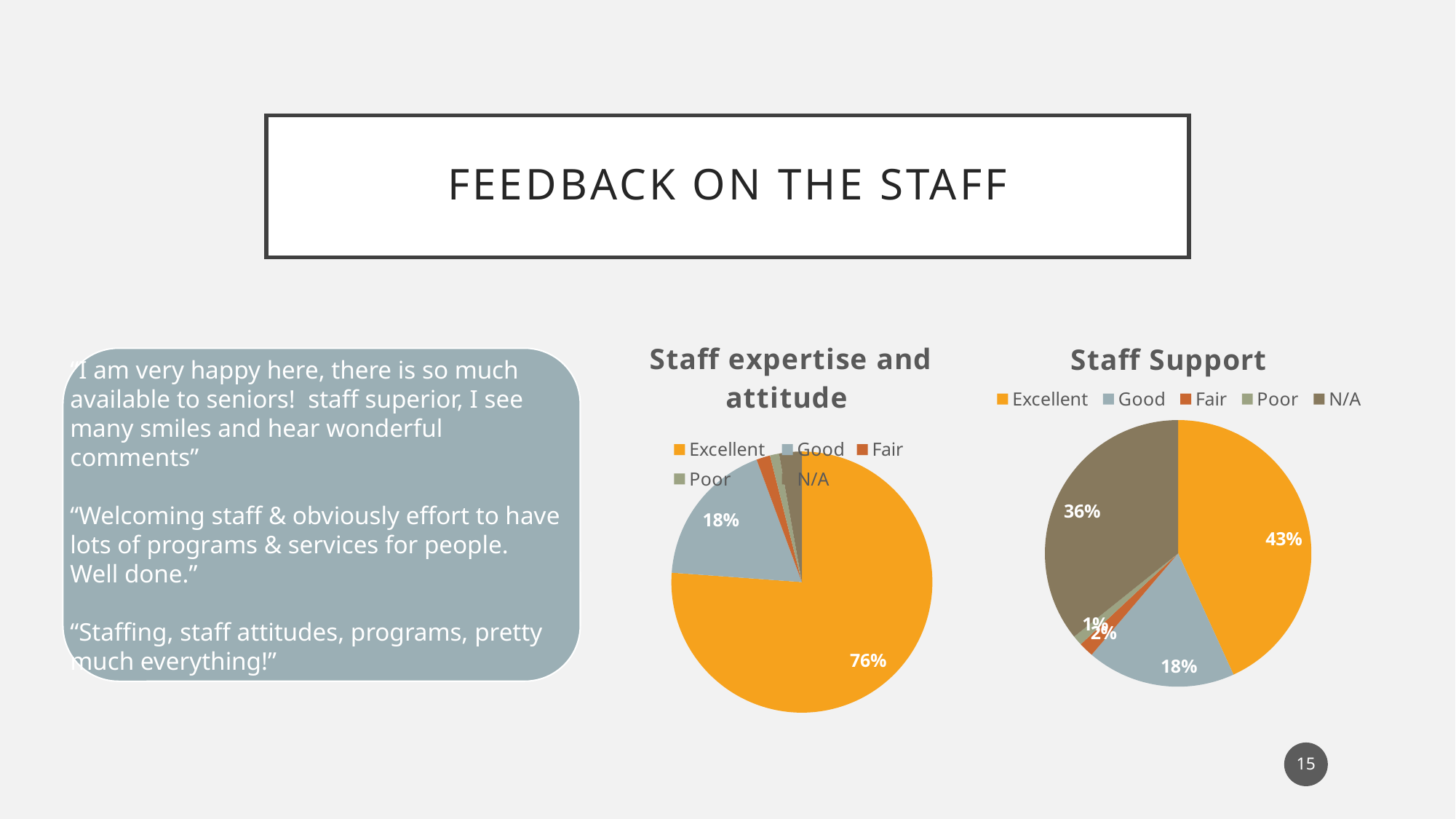
In the "Staff Support" pie chart, how many percentage points larger is the Excellent slice than the N/A slice? 7% In the "Staff expertise and attitude" pie chart, how many percentage points larger is the Excellent slice than the Good slice? 58% What type of chart is the "Staff Support" chart? Pie chart In the "Staff expertise and attitude" pie chart, what share is labelled for Good? 18% In the "Staff Support" pie chart, which slice is larger: Good or N/A? N/A In the "Staff Support" pie chart, what share is labelled for N/A? 36% In the "Staff Support" pie chart, which category has the largest slice? Excellent In the "Staff Support" pie chart, what share is labelled for Excellent? 43% In the "Staff expertise and attitude" pie chart, which category has the largest slice? Excellent In the "Staff Support" pie chart, what share is labelled for Good? 18% In the "Staff expertise and attitude" pie chart, what share is labelled for Excellent? 76% How many categories does the legend of the "Staff Support" chart list? 5